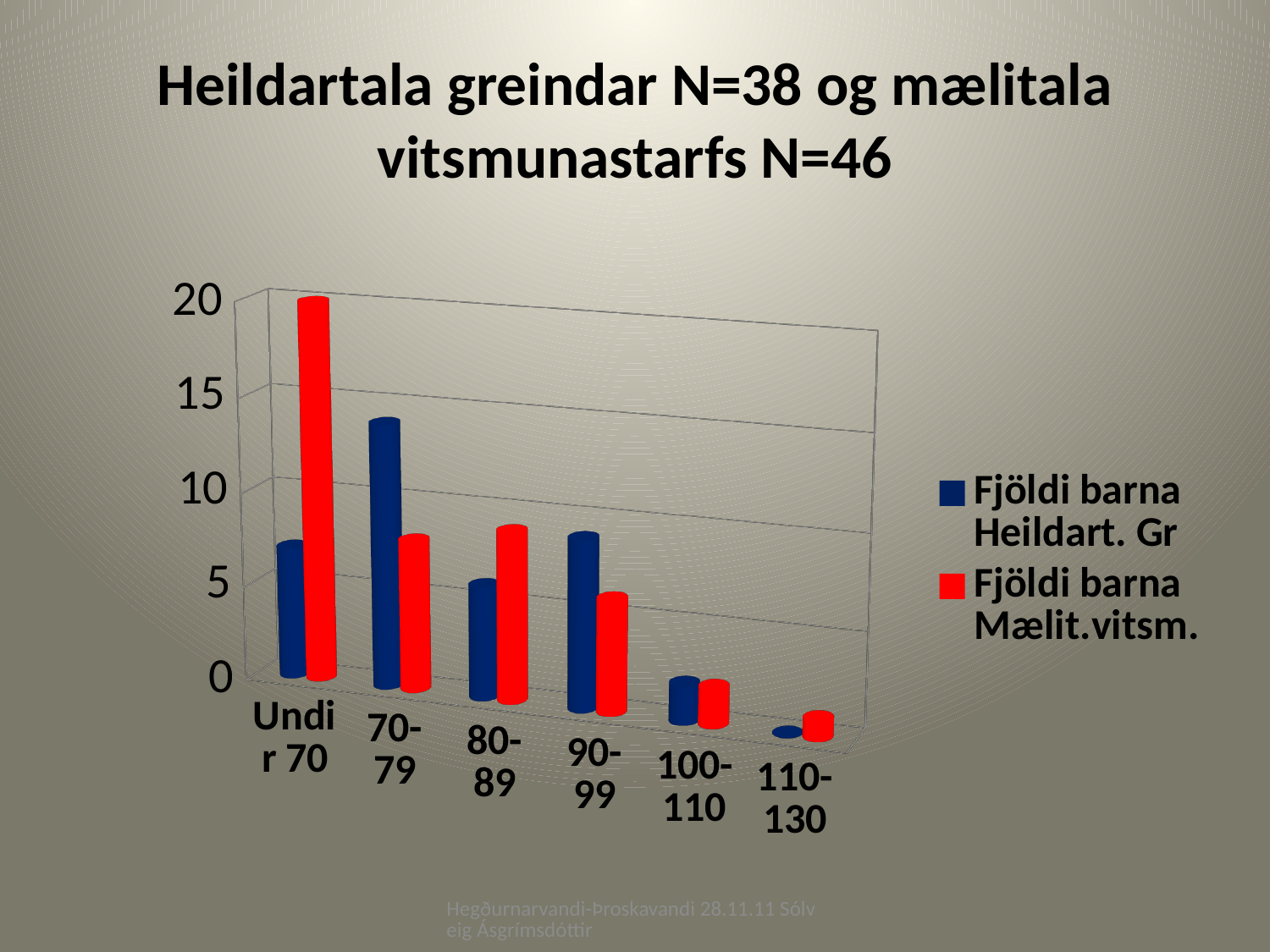
Which category has the highest value for the Fjöldi barna Mælit.vitsm. series? Undir 70 Is the value for Fjöldi barna Heildart. Gr in the 100-110 category greater or less than 5? less Which category has the lowest value for the Fjöldi barna Heildart. Gr series? 110-130 What kind of chart is shown on the slide? bar chart Is the value for Fjöldi barna Mælit.vitsm. in the Undir 70 category greater or less than 15? greater Is the value for Fjöldi barna Heildart. Gr in the 70-79 category greater or less than 10? greater Which category has the highest value for the Fjöldi barna Heildart. Gr series? 70-79 How many categories are shown on the x axis? 6 What colour represents the Fjöldi barna Mælit.vitsm. series in the legend? red In the Undir 70 category, which series has the larger value, Fjöldi barna Heildart. Gr or Fjöldi barna Mælit.vitsm.? Fjöldi barna Mælit.vitsm. How many series does the legend list? 2 In the 70-79 category, which series has the larger value, Fjöldi barna Heildart. Gr or Fjöldi barna Mælit.vitsm.? Fjöldi barna Heildart. Gr